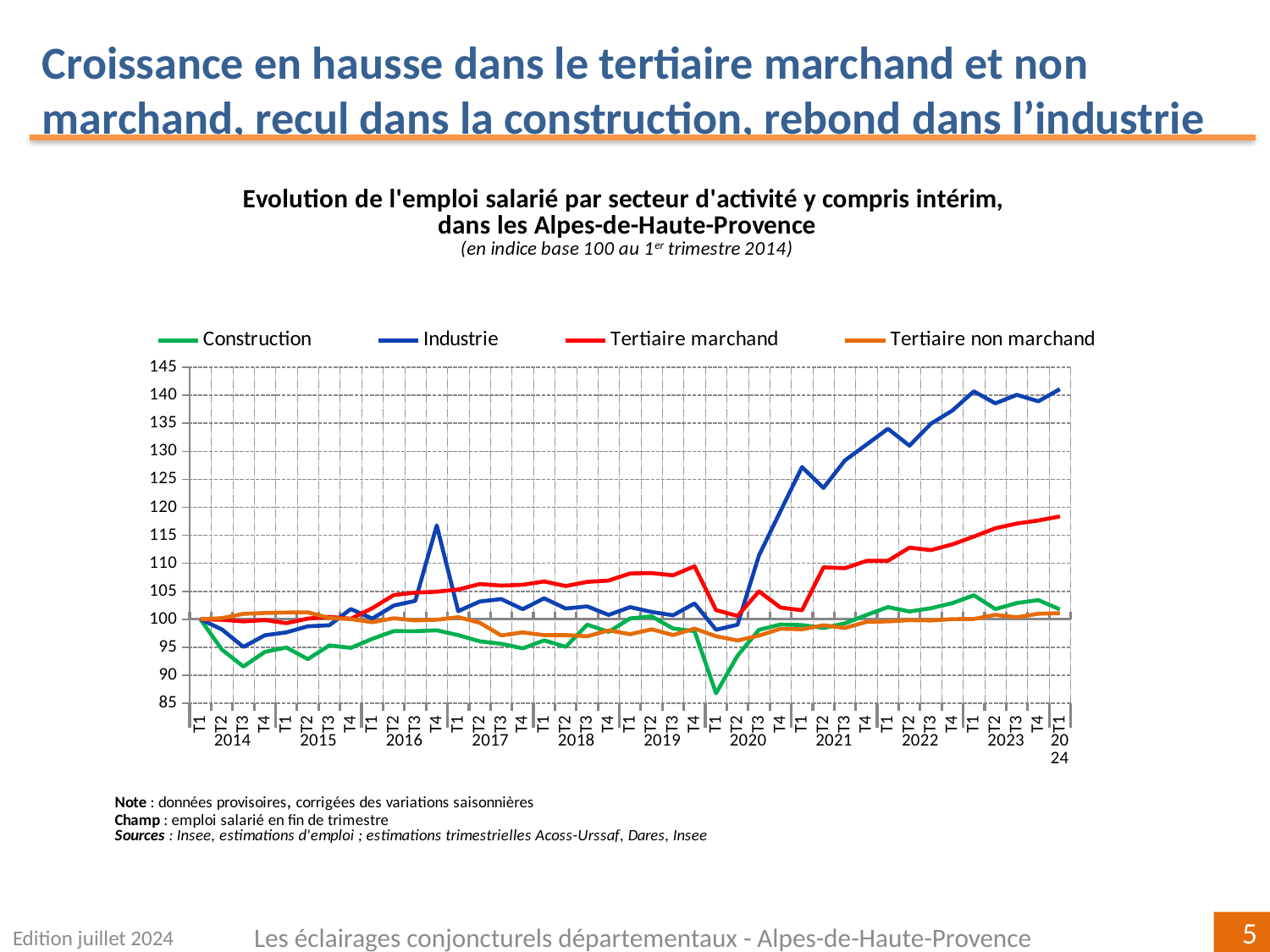
Is the value for Tertiaire marchand at T1 2024 greater or less than 115? greater What is the base of the index used in the chart, according to the subtitle? base 100 au 1er trimestre 2014 Is the value for Industrie at T1 2021 greater or less than 125? greater How many series does the legend list? 4 At T1 2024, which is larger: Tertiaire marchand or Construction? Tertiaire marchand Does the Industrie series rise or fall between T1 2020 and T1 2024? rise Is the value for Tertiaire non marchand at T1 2024 greater or less than 105? less Which series has the lowest value at T1 2020? Construction Which series has the highest value at T1 2024? Industrie What kind of chart is shown on the slide? line chart Which series is shown in blue in the legend? Industrie